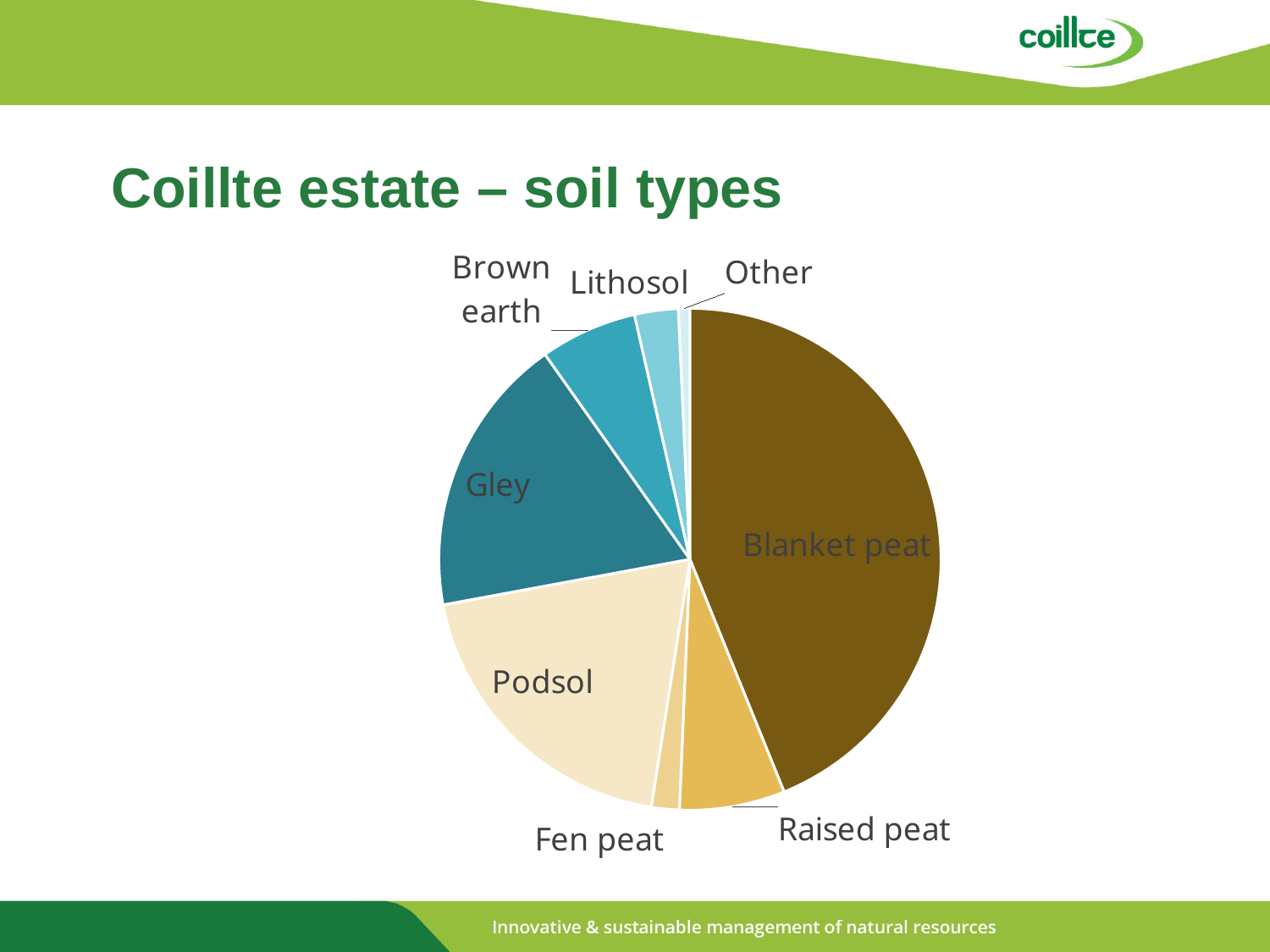
What colour is the Blanket peat slice? Brown Which is larger, the Blanket peat slice or the Podsol slice? Blanket peat Which is larger, the Podsol slice or the Raised peat slice? Podsol Which is larger, the Raised peat slice or the Lithosol slice? Raised peat Which soil type has the largest slice of the pie? Blanket peat What is the title of the slide containing the pie chart? Coillte estate – soil types What kind of chart is shown on the slide? Pie chart